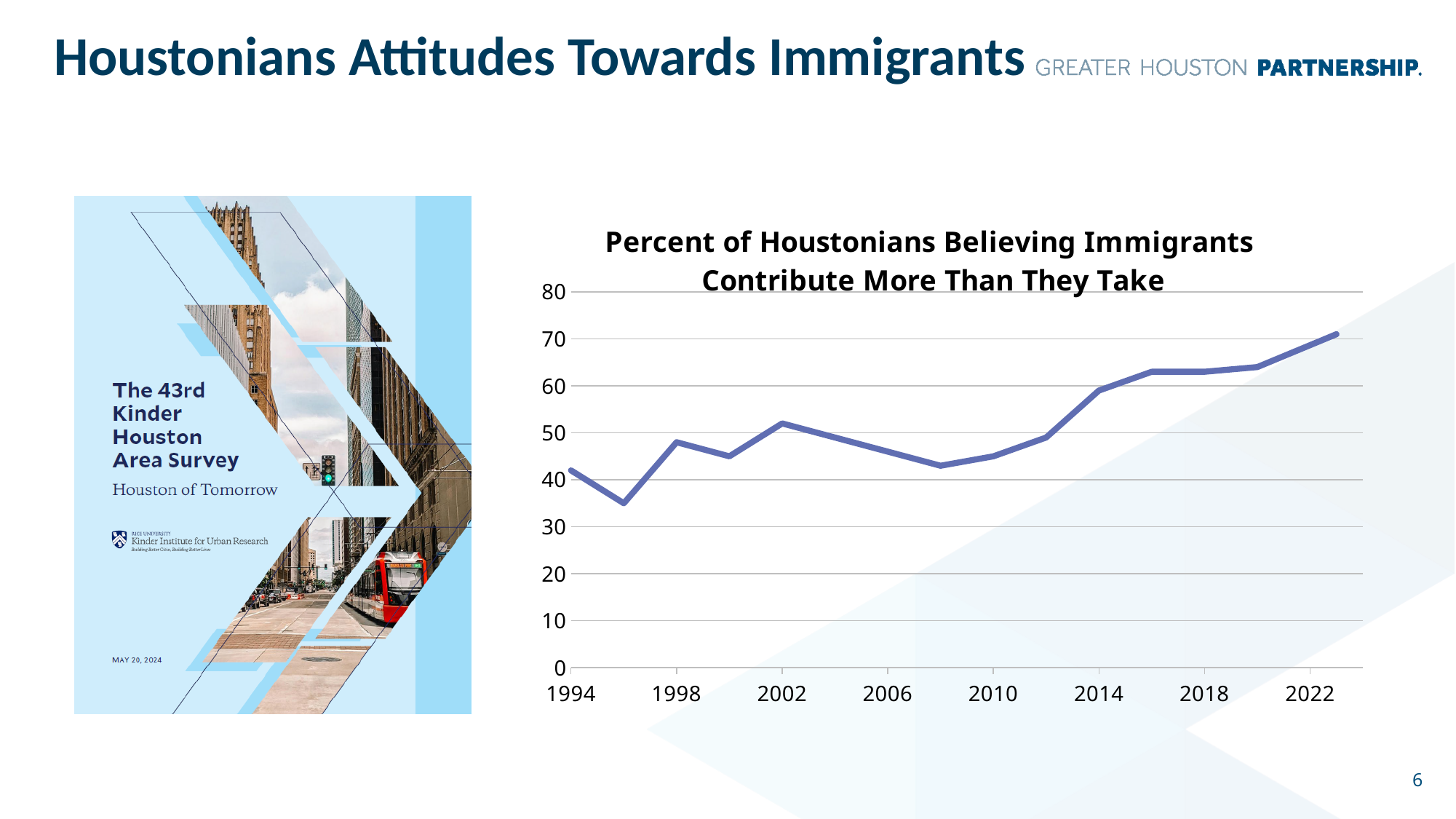
Is the value for 2002 greater or less than 50? greater Which is larger, the value for 1994 or the value for 1998? 1998 Is the value for 2022 greater or less than 60? greater Is the highest point on the line at the beginning or the end of the period shown? the end Do the values generally rise or fall between 2010 and 2022? rise What kind of chart is shown on the slide? line chart Is the value for 2018 greater or less than 60? greater What is the title of the chart? Percent of Houstonians Believing Immigrants Contribute More Than They Take Which is larger, the value for 2002 or the value for 2014? 2014